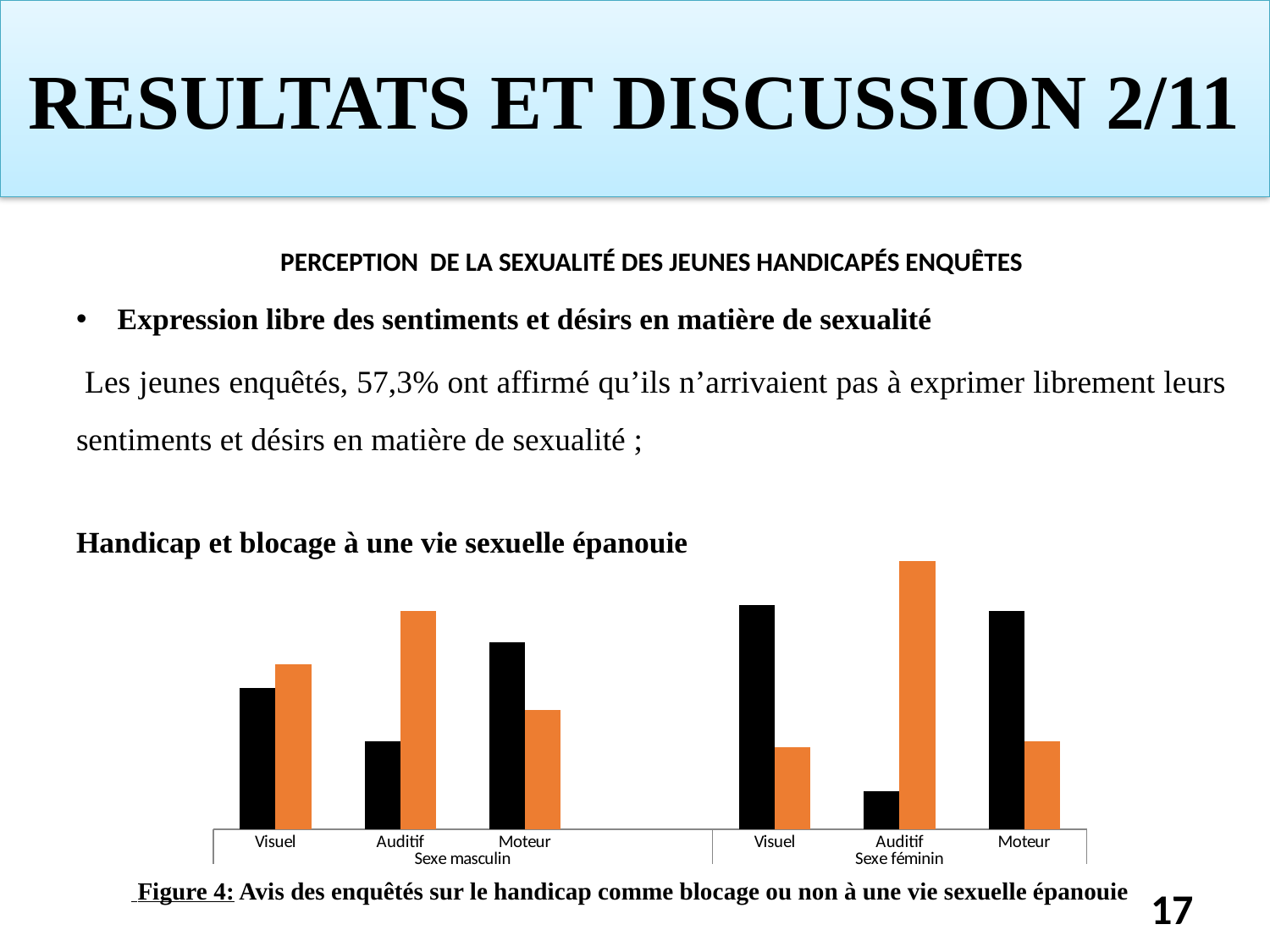
How many groups (sexes) are the categories divided into on the x axis? 2 Within the Sexe masculin group, which category has the tallest orange bar? Auditif For Visuel under Sexe féminin, which bar is taller, the black one or the orange one? black Which category has the tallest orange bar in the whole chart? Auditif (Sexe féminin) How many bars are plotted for each category in the chart? 2 For Moteur under Sexe féminin, which bar is taller, the black one or the orange one? black What kind of chart is shown in Figure 4? bar chart What is the figure caption given below the chart? Figure 4: Avis des enquêtés sur le handicap comme blocage ou non à une vie sexuelle épanouie How many categories are shown along the x axis of the chart? 6 For Auditif under Sexe masculin, which bar is taller, the black one or the orange one? orange Which category has the shortest black bar in the whole chart? Auditif (Sexe féminin)